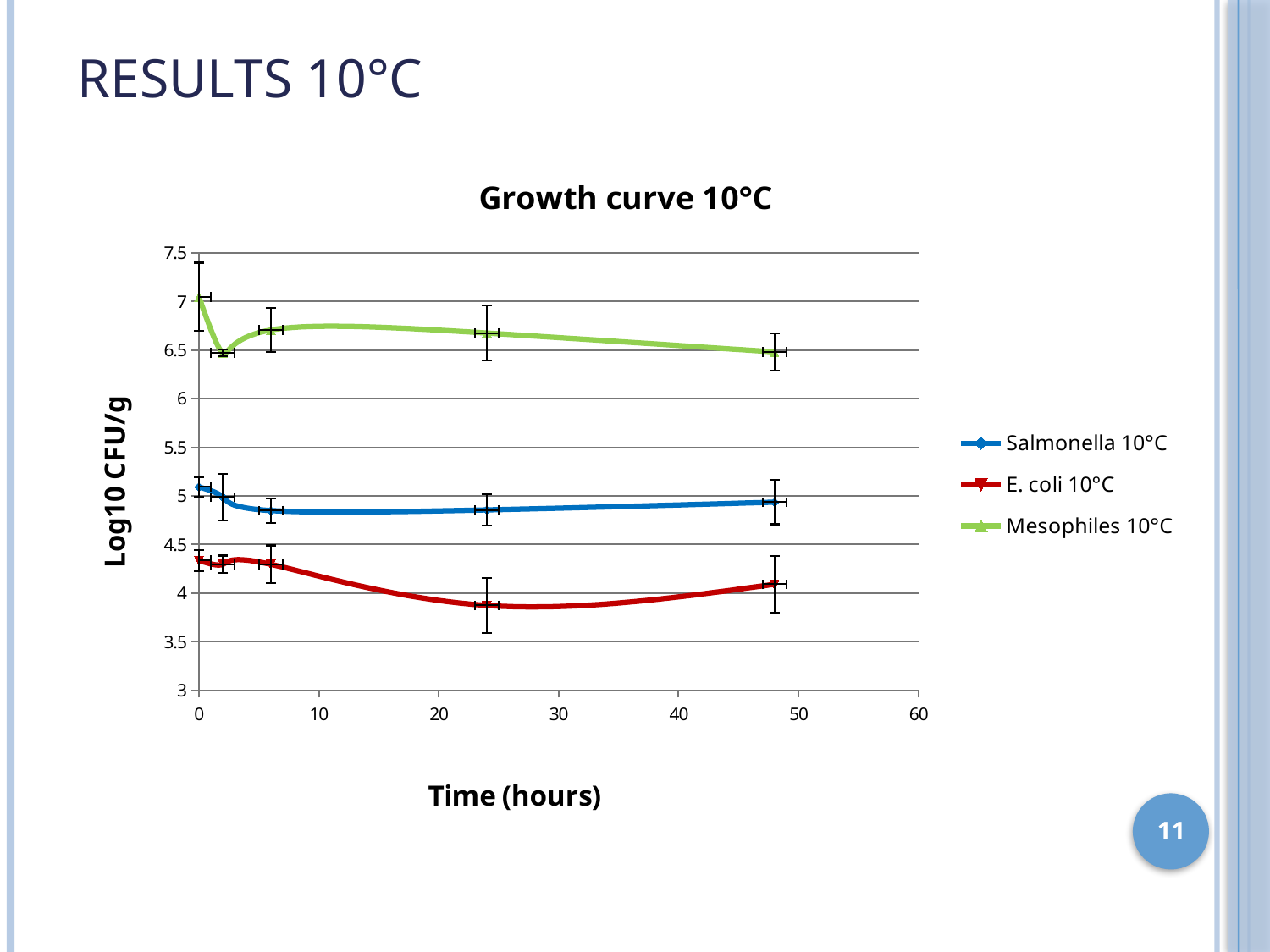
What is the label of the y axis? Log10 CFU/g Which series has the lowest values throughout the chart? E. coli 10°C What kind of chart is shown on the slide? line chart How many series does the legend list? 3 Is the value for Mesophiles 10°C at 24 hours greater or less than 6? greater Which series has the highest values throughout the chart? Mesophiles 10°C Is the value for Salmonella 10°C at 48 hours greater or less than 4.5? greater Is the value for E. coli 10°C at 24 hours greater or less than 4? less What is the title of the chart? Growth curve 10°C At 24 hours, which is larger: the value for Salmonella 10°C or the value for E. coli 10°C? Salmonella 10°C How many data points are plotted for the Salmonella 10°C series? 5 Does the E. coli 10°C series rise or fall between 0 and 24 hours? fall